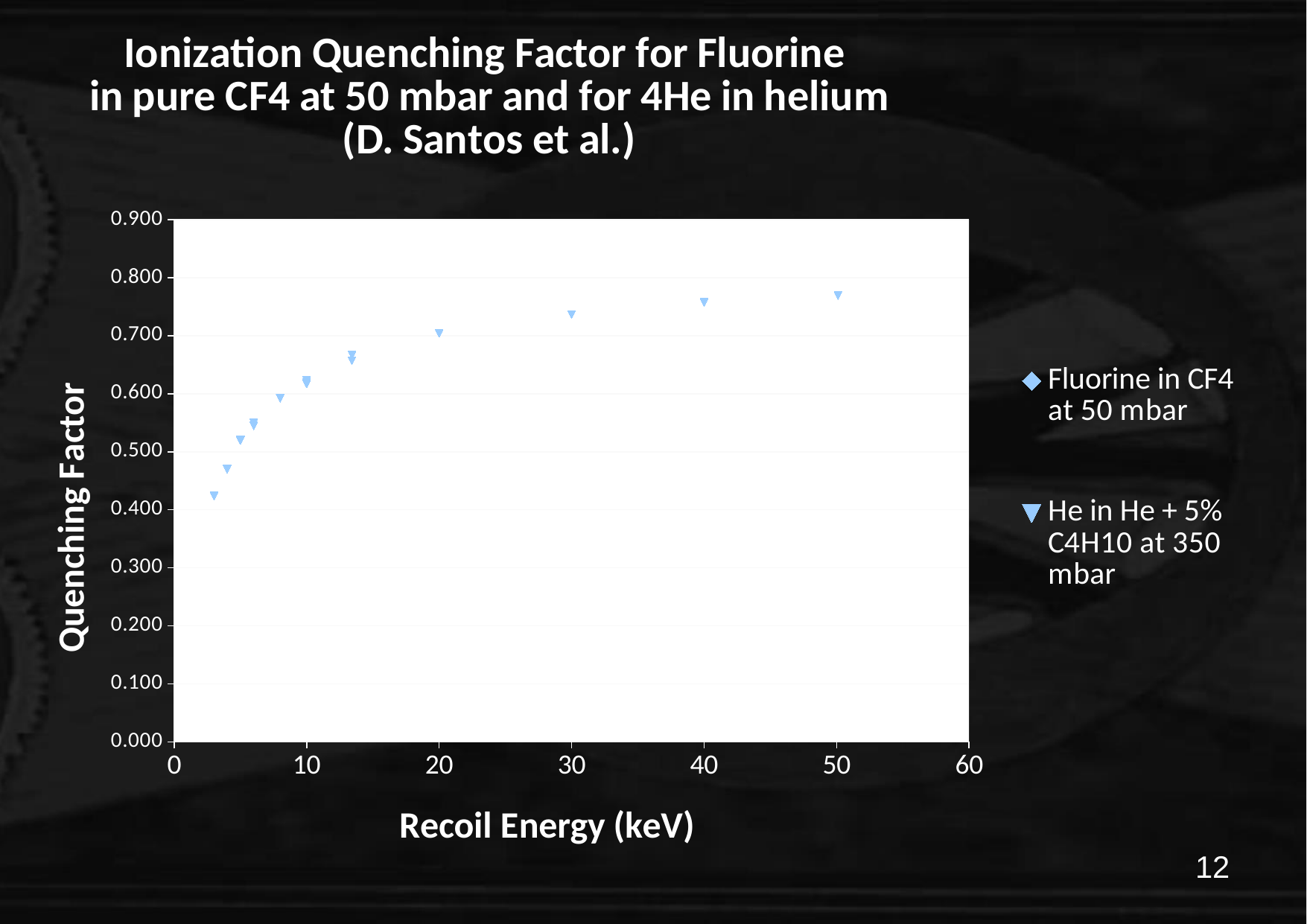
Does the quenching factor rise or fall as recoil energy increases? rise Is the quenching factor at 50 keV greater or less than 0.700? greater At which recoil energy is the plotted quenching factor highest? 50 keV Is the lowest plotted quenching factor greater or less than 0.500? less Is the quenching factor at 20 keV greater or less than 0.600? greater How many series does the legend list? 2 What kind of chart is shown on the slide? scatter chart What is the label of the y axis? Quenching Factor What is the label of the x axis? Recoil Energy (keV)